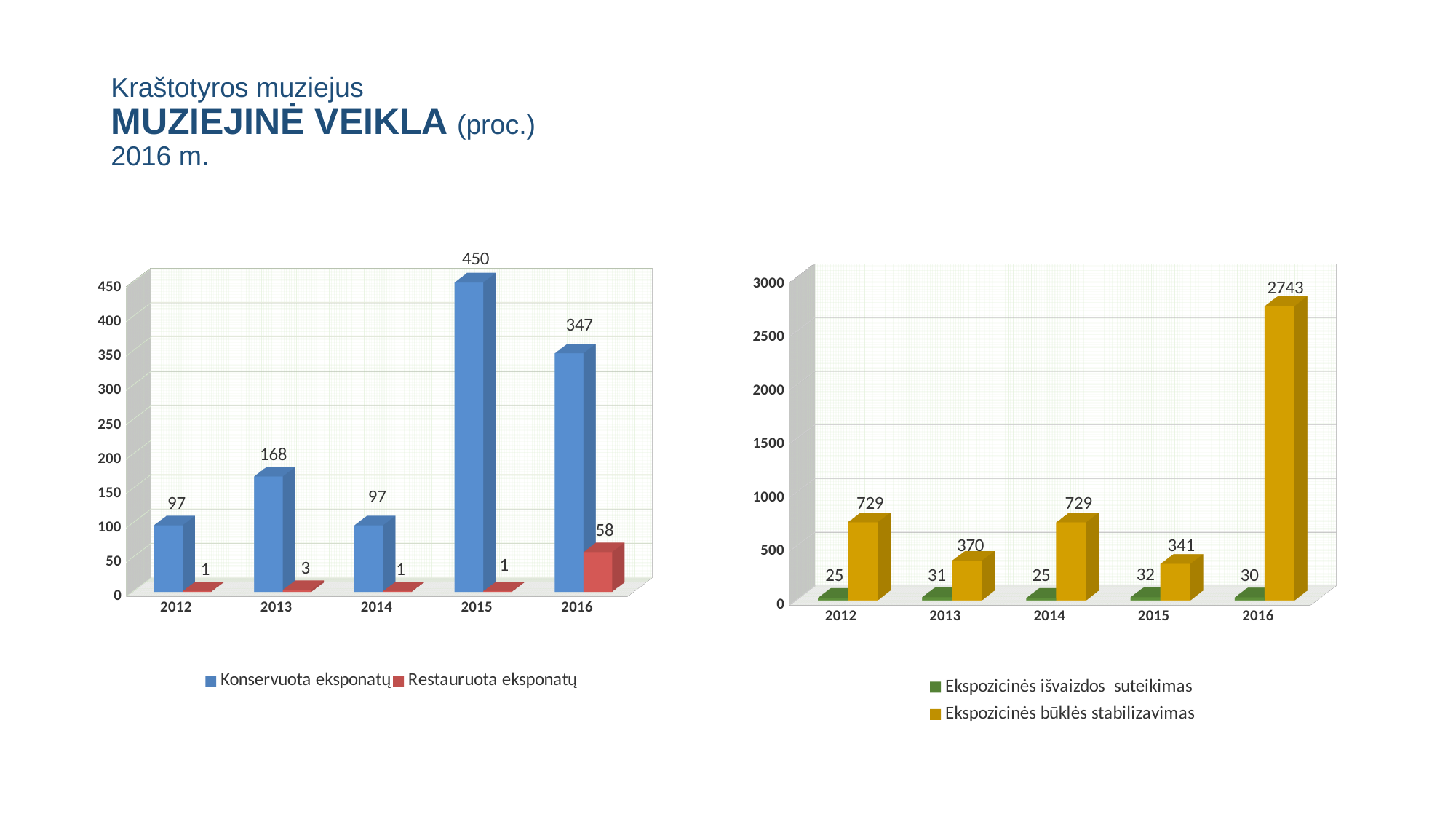
In the left chart, what is the value of Restauruota eksponatų for 2016? 58 In the right chart, which year has the lowest value for Ekspozicinės būklės stabilizavimas? 2015 In the right chart, which is larger: Ekspozicinės būklės stabilizavimas in 2013 or in 2014? 2014 In the left chart, what is the difference between Konservuota eksponatų in 2015 and 2016? 103 In the right chart, what is the value of Ekspozicinės išvaizdos suteikimas for 2013? 31 In the left chart, how many series does the legend list? 2 In the left chart, which year has the highest value for Konservuota eksponatų? 2015 In the right chart, what colour are the bars for Ekspozicinės būklės stabilizavimas? Yellow In the left chart, what is the value of Konservuota eksponatų for 2015? 450 In the right chart, what is the value of Ekspozicinės būklės stabilizavimas for 2016? 2743 In the left chart, what kind of chart is shown? Bar chart In the right chart, how many years are shown on the x axis? 5